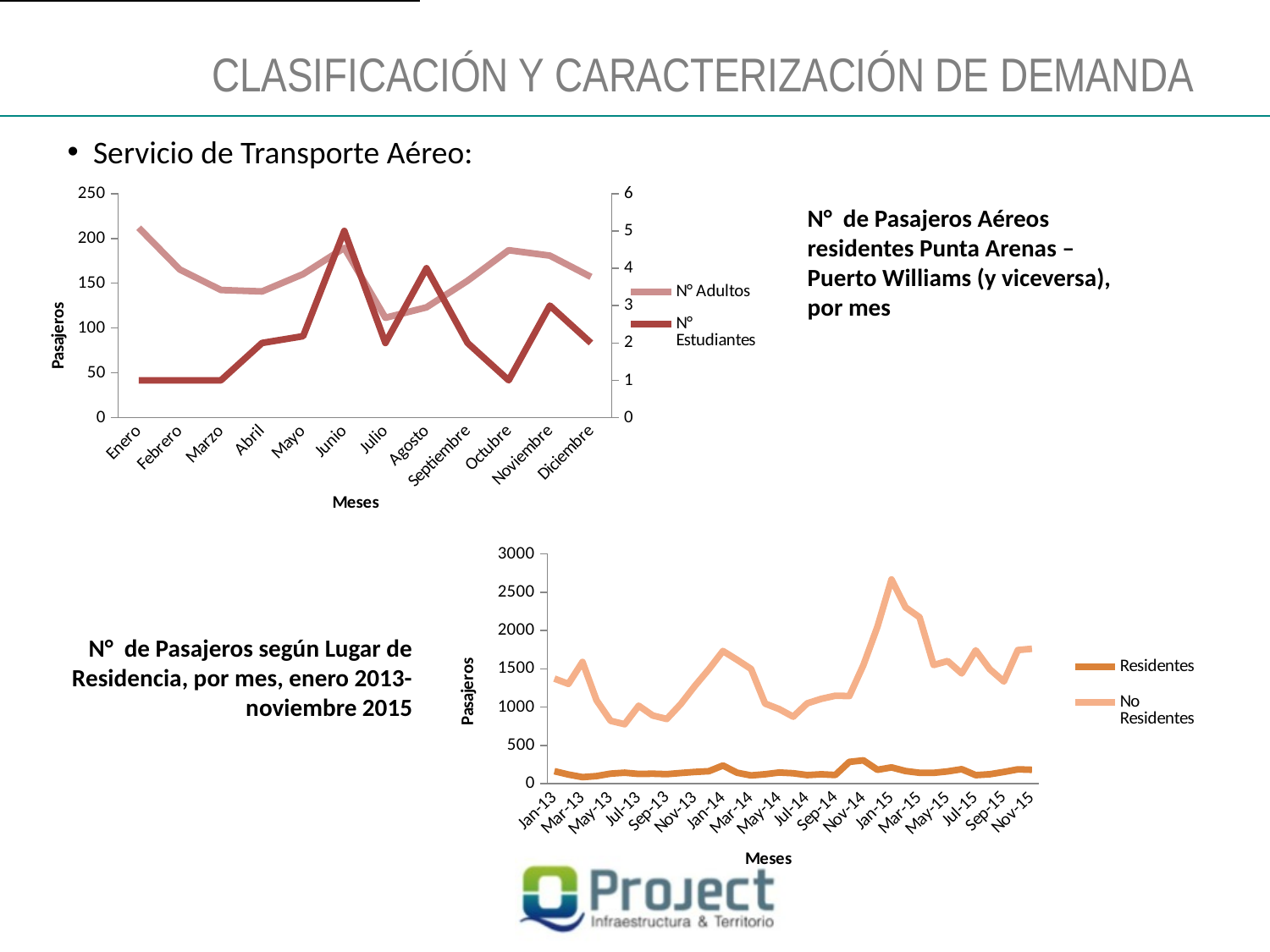
In the top chart (Punta Arenas – Puerto Williams), is the value for N° Adultos in Enero greater or less than 200? greater In the top chart (Punta Arenas – Puerto Williams), does the N° Adultos line rise or fall from Enero to Marzo? Falls In the bottom chart (Pasajeros según Lugar de Residencia), which series is larger in Jan-13, Residentes or No Residentes? No Residentes In the bottom chart (Pasajeros según Lugar de Residencia), is the value for No Residentes in Jan-15 greater or less than 2500? greater What kind of chart is the top chart titled 'N° de Pasajeros Aéreos residentes Punta Arenas – Puerto Williams (y viceversa), por mes'? Line chart How many months are plotted along the x axis of the top chart (Punta Arenas – Puerto Williams)? 12 In the bottom chart (Pasajeros según Lugar de Residencia), which month has the highest value for No Residentes? Jan-15 In the top chart (Punta Arenas – Puerto Williams), which month has the highest value for N° Adultos? Enero In the top chart (Punta Arenas – Puerto Williams), is the value for N° Adultos in Julio greater or less than 150? less In the top chart (Punta Arenas – Puerto Williams), which month has the highest value for N° Estudiantes? Junio How many series does the legend of the top chart (Punta Arenas – Puerto Williams) list? 2 What kind of chart is the bottom chart titled 'N° de Pasajeros según Lugar de Residencia, por mes, enero 2013-noviembre 2015'? Line chart